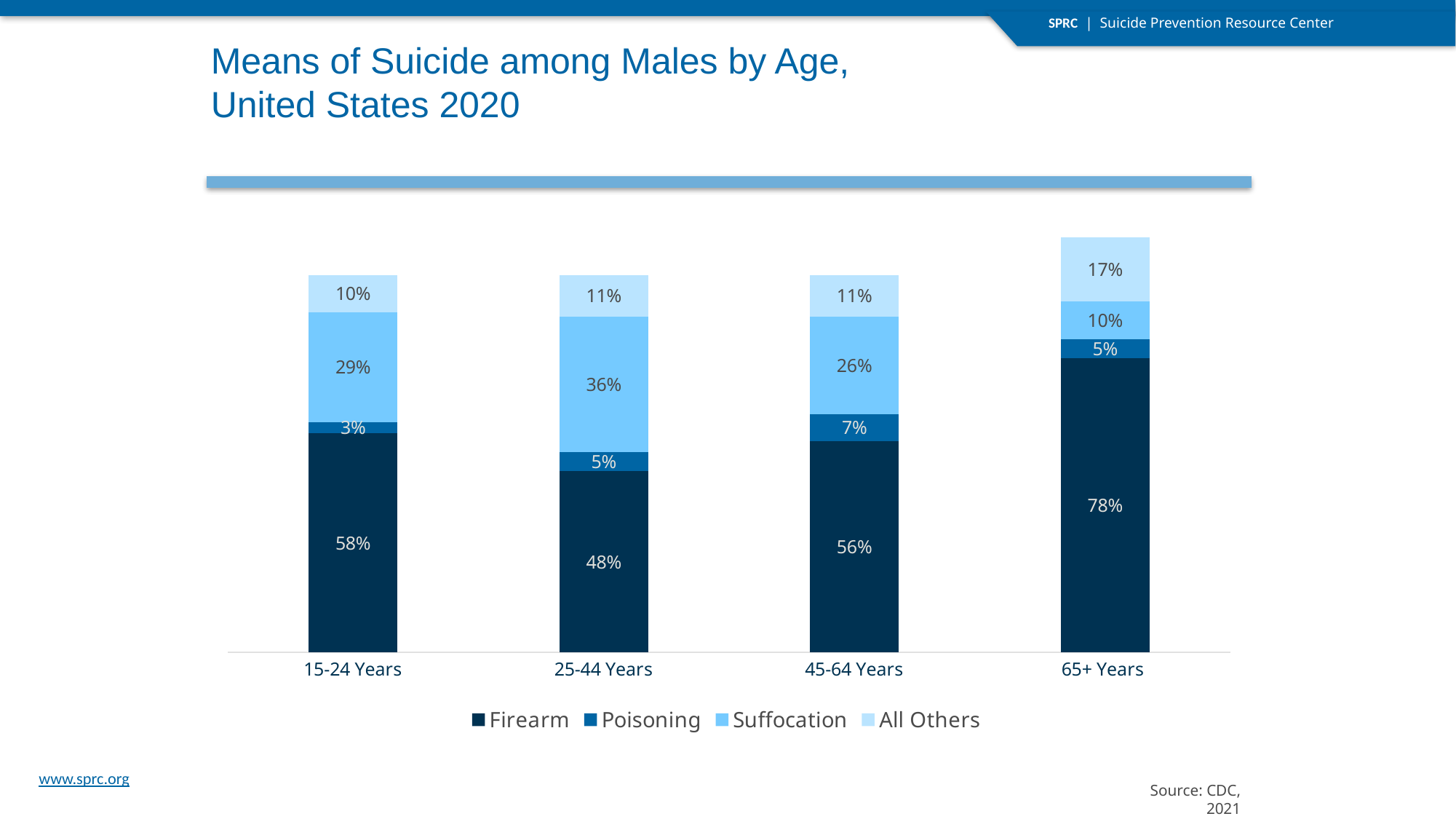
What kind of chart is shown on the slide? Stacked bar chart What is the Poisoning value for the 45-64 Years age group? 7% What is the All Others value for the 65+ Years age group? 17% What percentage of suicides among males aged 15-24 years were by firearm? 58% What is the Suffocation value for the 25-44 Years age group? 36% Which age group has the lowest Poisoning percentage? 15-24 Years Which is larger: the Suffocation value for 15-24 Years or for 45-64 Years? 15-24 Years How many age groups are shown on the x axis? 4 How many series does the legend list? 4 What is the total of the stacked bar for 65+ Years? 110% Which age group has the highest Firearm percentage? 65+ Years What is the difference between the Firearm percentage for 65+ Years and for 25-44 Years? 30%